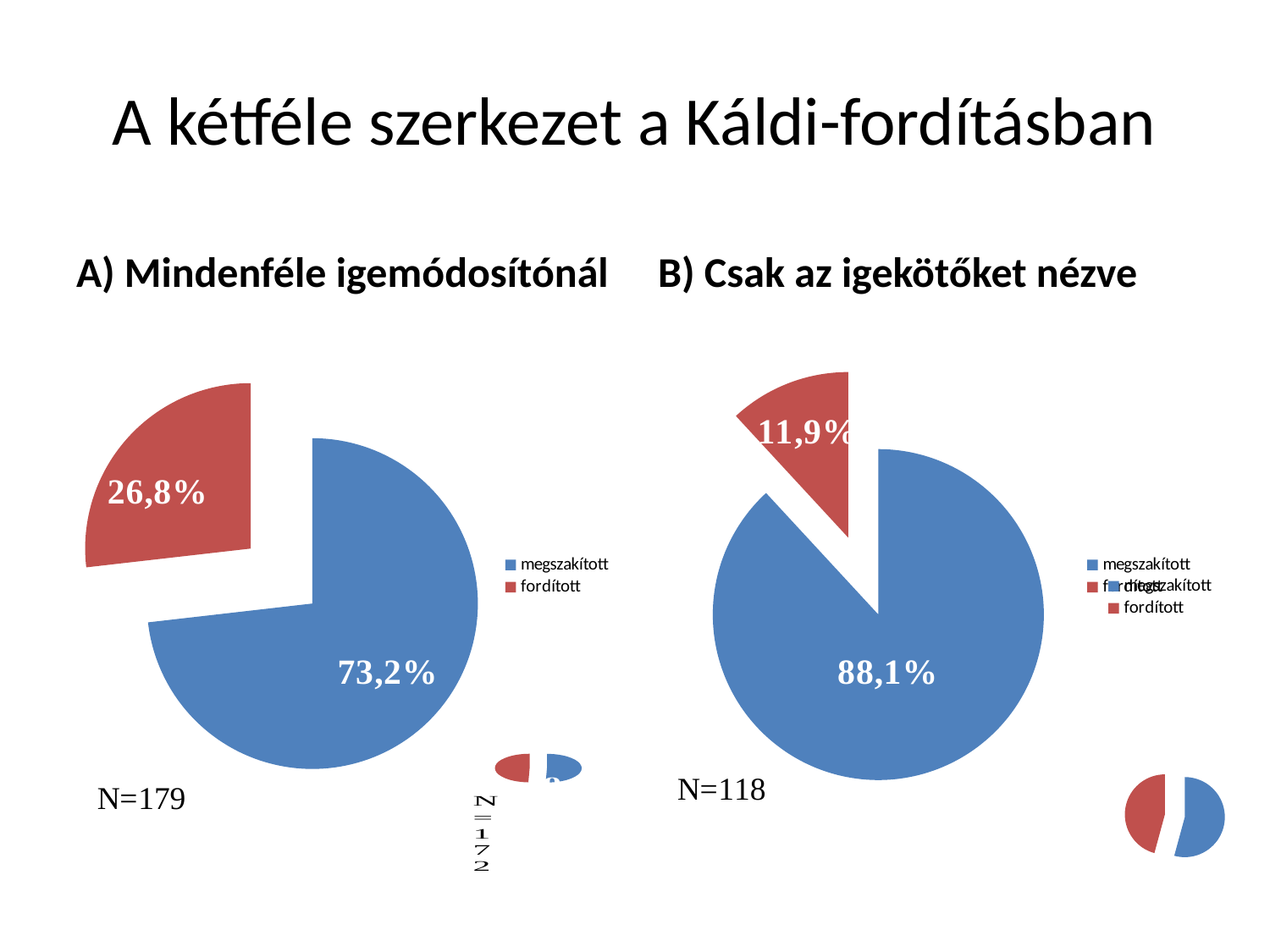
In the chart titled "A) Mindenféle igemódosítónál", what colour is the "fordított" slice? red What is the N value shown below the chart titled "B) Csak az igekötőket nézve"? N=118 In the chart titled "A) Mindenféle igemódosítónál", which category has the largest slice? megszakított In the chart titled "A) Mindenféle igemódosítónál", what is the difference between the "megszakított" and "fordított" shares? 46,4% How many slices does the chart titled "A) Mindenféle igemódosítónál" have? 2 Is the "fordított" share larger in the chart titled "A) Mindenféle igemódosítónál" or in the chart titled "B) Csak az igekötőket nézve"? A) Mindenféle igemódosítónál In the chart titled "A) Mindenféle igemódosítónál", what share does the "fordított" slice have? 26,8% In the chart titled "B) Csak az igekötőket nézve", what share does the "megszakított" slice have? 88,1% In the chart titled "B) Csak az igekötőket nézve", what share does the "fordított" slice have? 11,9% In the chart titled "B) Csak az igekötőket nézve", which category has the smallest slice? fordított What kind of chart is used under the heading "B) Csak az igekötőket nézve"? pie chart In the chart titled "A) Mindenféle igemódosítónál", what share does the "megszakított" slice have? 73,2%